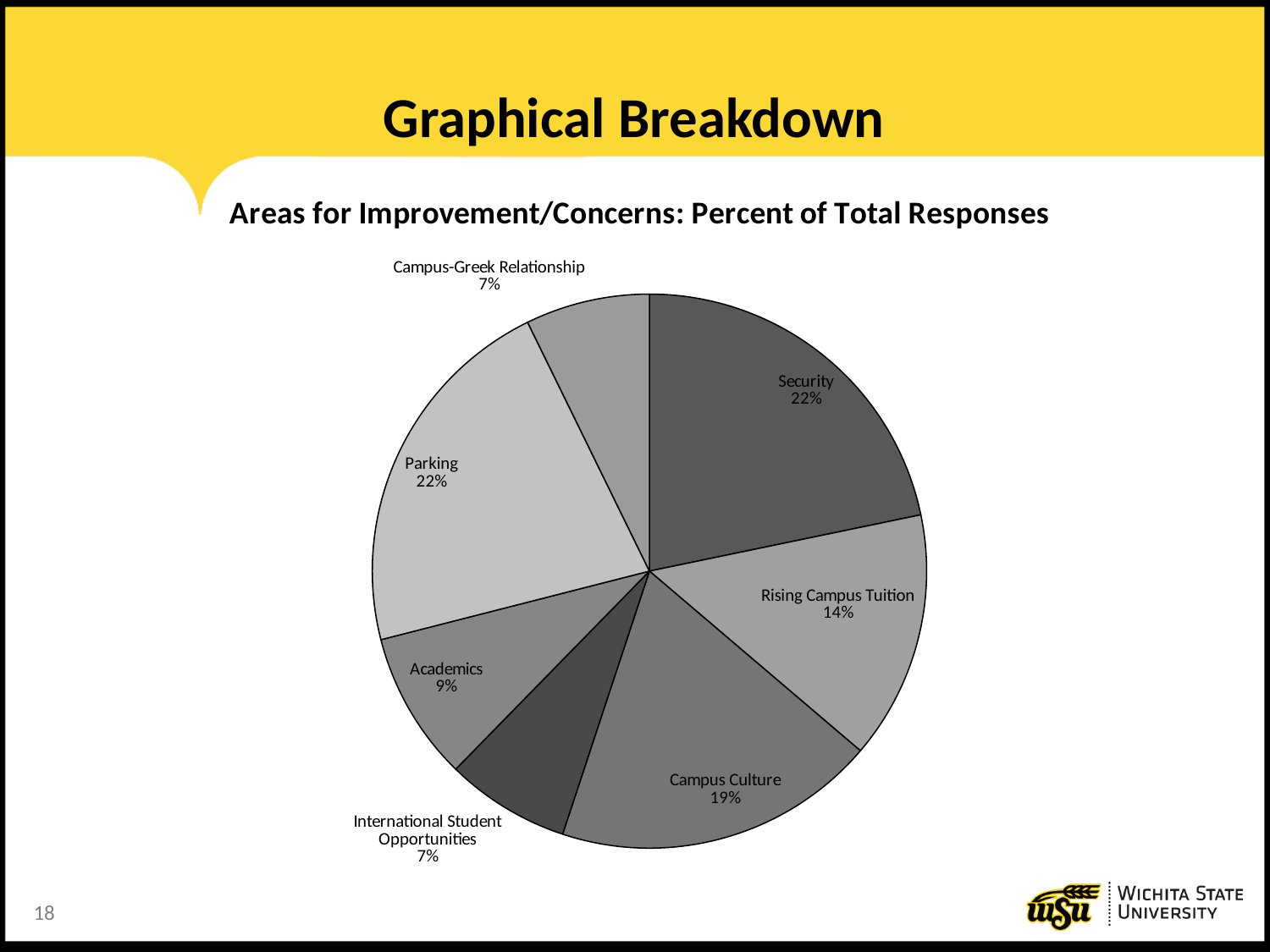
What percentage of total responses is Academics? 9% How many categories are shown in the pie chart? 7 What percentage of total responses is International Student Opportunities? 7% What percentage of total responses is Rising Campus Tuition? 14% Which has a larger share of responses, Academics or Campus Culture? Campus Culture What percentage of total responses is Parking? 22% What is the title of the chart? Areas for Improvement/Concerns: Percent of Total Responses What is the difference in percentage points between Campus Culture and Rising Campus Tuition? 5 What percentage of total responses is Campus Culture? 19% What percentage of total responses is Security? 22% What kind of chart is shown on the slide? Pie chart Which has a larger share of responses, Parking or Rising Campus Tuition? Parking